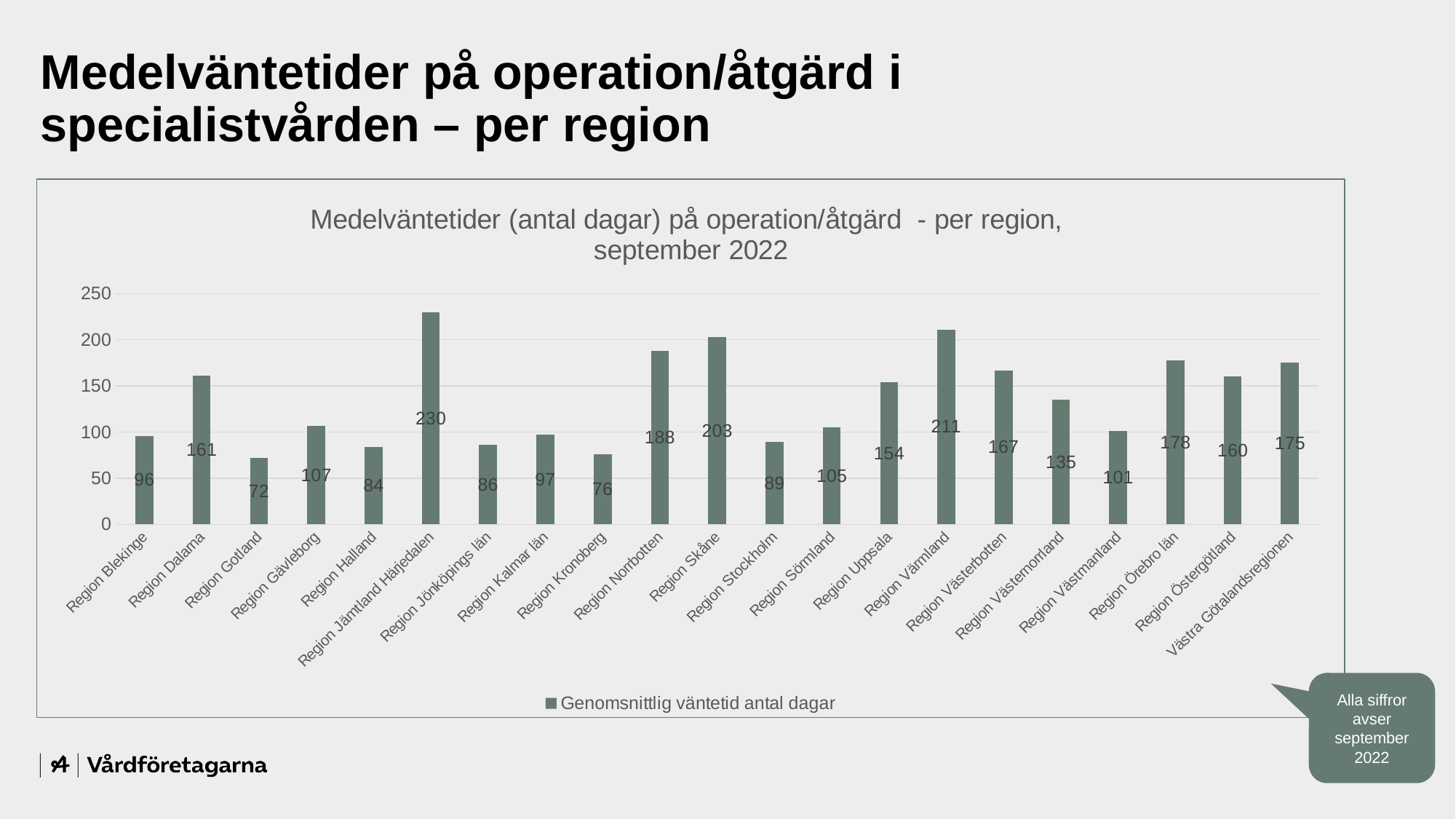
What is the average waiting time in days for Region Skåne? 203 How many regions are shown on the x axis? 21 What is the legend entry of the chart? Genomsnittlig väntetid antal dagar Which region has the lowest average waiting time? Region Gotland Which region has the highest average waiting time? Region Jämtland Härjedalen What value is shown for Region Stockholm? 89 How many series does the legend list? 1 Is the value for Region Västernorrland greater or less than 150? less Which has a higher value, Region Dalarna or Region Östergötland? Region Dalarna What is the difference in days between Region Värmland and Region Norrbotten? 23 What is the value for Västra Götalandsregionen? 175 What kind of chart is shown on the slide? Bar chart